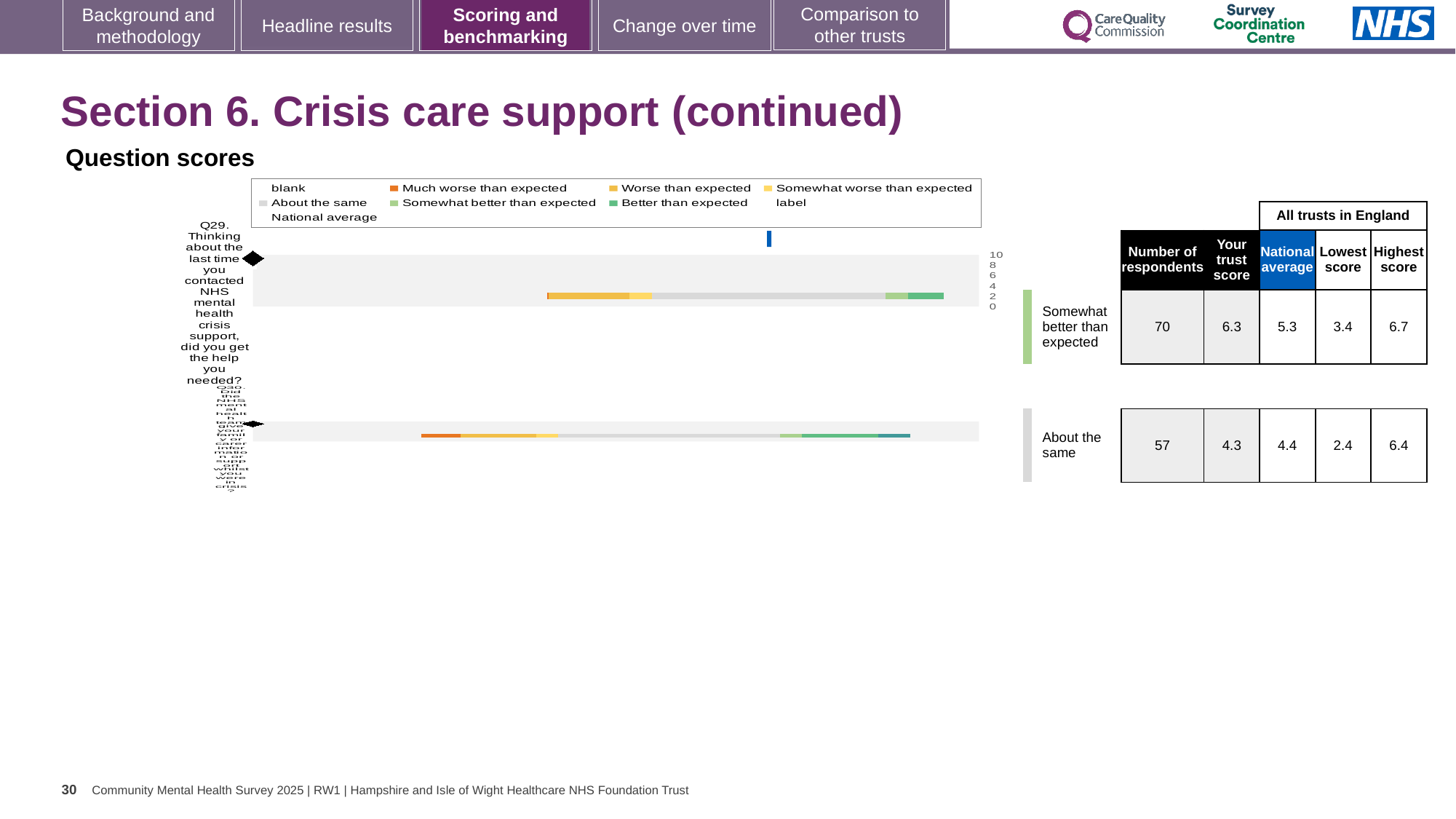
What kind of chart is used to show the question scores on this slide? bar chart What is the lowest score among all trusts in England for Q29? 3.4 Which question has the larger number of respondents, Q29 or Q30? Q29 What is the national average score for Q29? 5.3 What is the highest score among all trusts in England for Q30? 6.4 How many respondents answered Q30 (Did the NHS mental health team give your family or carer information or support whilst you were in crisis?)? 57 What is the difference between the highest and lowest scores among all trusts in England for Q30? 4.0 What is the trust score for Q29 (Thinking about the last time you contacted NHS mental health crisis support, did you get the help you needed?)? 6.3 What is the difference between the trust score and the national average for Q29? 1.0 Which benchmark category is Q29 placed in? Somewhat better than expected How many questions are plotted in the question scores chart? 2 Is the trust score for Q30 higher or lower than the national average for Q30? lower